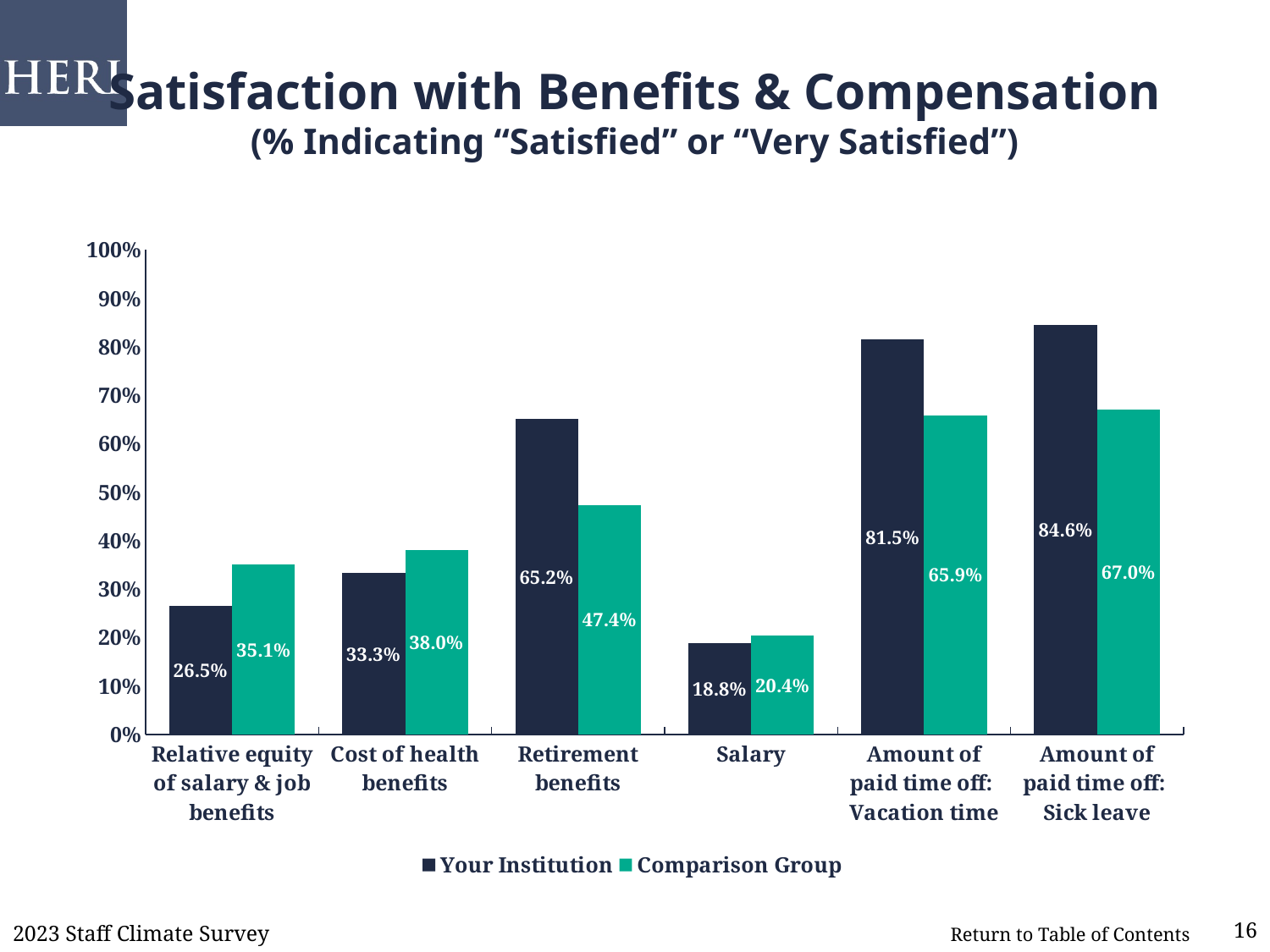
For Cost of health benefits, which is larger: Your Institution or the Comparison Group? Comparison Group Which category has the lowest value for the Comparison Group? Salary What is the value for Your Institution for Amount of paid time off: Vacation time? 81.5% What is the value for Your Institution for Retirement benefits? 65.2% What is the value for the Comparison Group for Salary? 20.4% What is the difference between Your Institution and the Comparison Group for Relative equity of salary & job benefits? 8.6 percentage points What is the difference between Your Institution and the Comparison Group for Retirement benefits? 17.8 percentage points Is the value for Your Institution for Amount of paid time off: Sick leave greater or less than 80%? greater What kind of chart is shown on the slide? Bar chart How many series does the legend list? 2 How many categories are shown on the x axis? 6 Which category has the highest value for Your Institution? Amount of paid time off: Sick leave